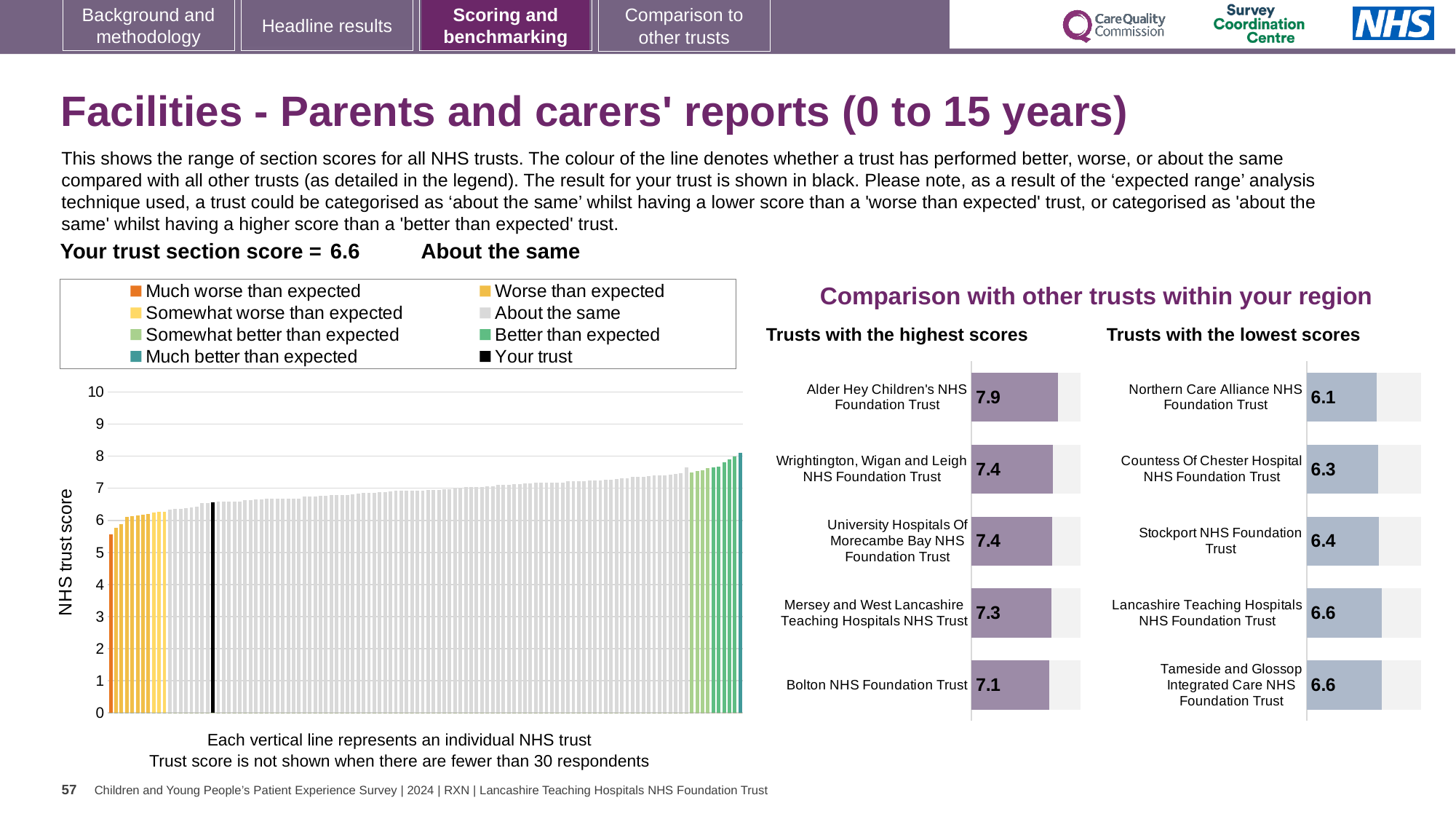
In the 'Trusts with the highest scores' chart, which trust has the highest score? Alder Hey Children's NHS Foundation Trust In the 'Trusts with the highest scores' chart, how many trusts are shown? 5 In the 'Trusts with the lowest scores' chart, which trust has the lowest score? Northern Care Alliance NHS Foundation Trust In the 'Trusts with the highest scores' chart, what is the difference between the scores of Alder Hey Children's NHS Foundation Trust and Bolton NHS Foundation Trust? 0.8 In the 'Trusts with the highest scores' chart, what is the score for Alder Hey Children's NHS Foundation Trust? 7.9 How many entries does the legend of the large chart on the left list? 8 In the 'Trusts with the highest scores' chart, what is the score for Bolton NHS Foundation Trust? 7.1 In the 'Trusts with the lowest scores' chart, what is the score for Stockport NHS Foundation Trust? 6.4 In the 'Trusts with the lowest scores' chart, which has the larger score: Countess Of Chester Hospital NHS Foundation Trust or Stockport NHS Foundation Trust? Stockport NHS Foundation Trust In the large chart on the left showing NHS trust scores, do the values rise or fall from left to right? rise In the 'Trusts with the lowest scores' chart, what is the difference between the scores of Stockport NHS Foundation Trust and Northern Care Alliance NHS Foundation Trust? 0.3 In the 'Trusts with the lowest scores' chart, what is the score for Northern Care Alliance NHS Foundation Trust? 6.1